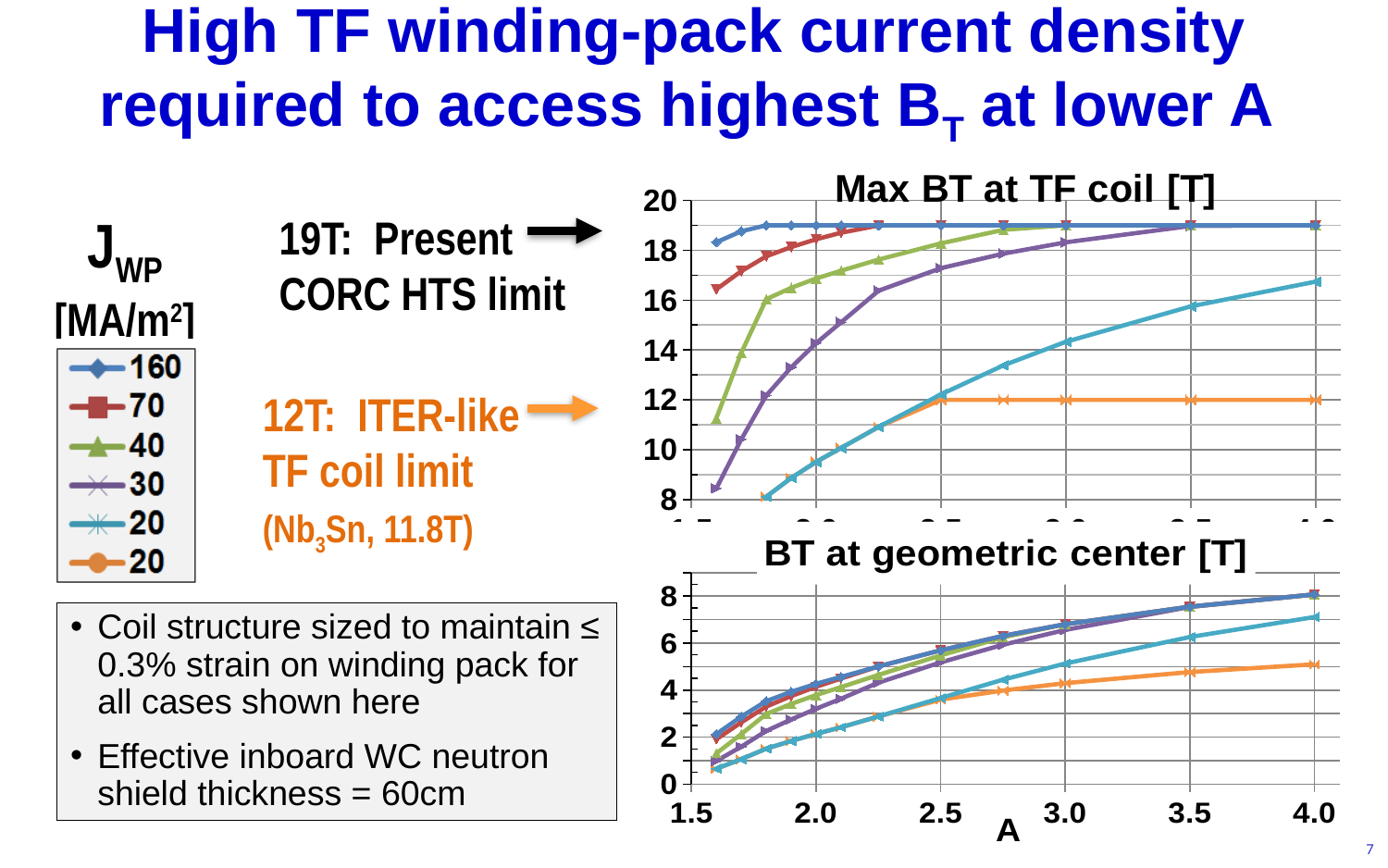
What kind of chart is the 'Max BT at TF coil [T]' chart? line chart In the 'Max BT at TF coil [T]' chart, is the value for the orange 20 series at A = 4.0 greater or less than 14? less In the 'Max BT at TF coil [T]' chart, which is larger at A = 2.0: the 160 series or the 30 series? 160 In the 'BT at geometric center [T]' chart, which is larger at A = 2.0: the 160 series or the 30 series? 160 In the 'BT at geometric center [T]' chart, is the value for the orange 20 series at A = 4.0 greater or less than 6? less In the 'BT at geometric center [T]' chart, is the value for the 160 series at A = 4.0 greater or less than 6? greater What is the x-axis label shown under the bottom chart? A How many series does the legend list for the charts? 6 In the 'Max BT at TF coil [T]' chart, do the values for the 30 series rise or fall as A increases? rise In the 'BT at geometric center [T]' chart, do the values for the 160 series rise or fall as A increases? rise